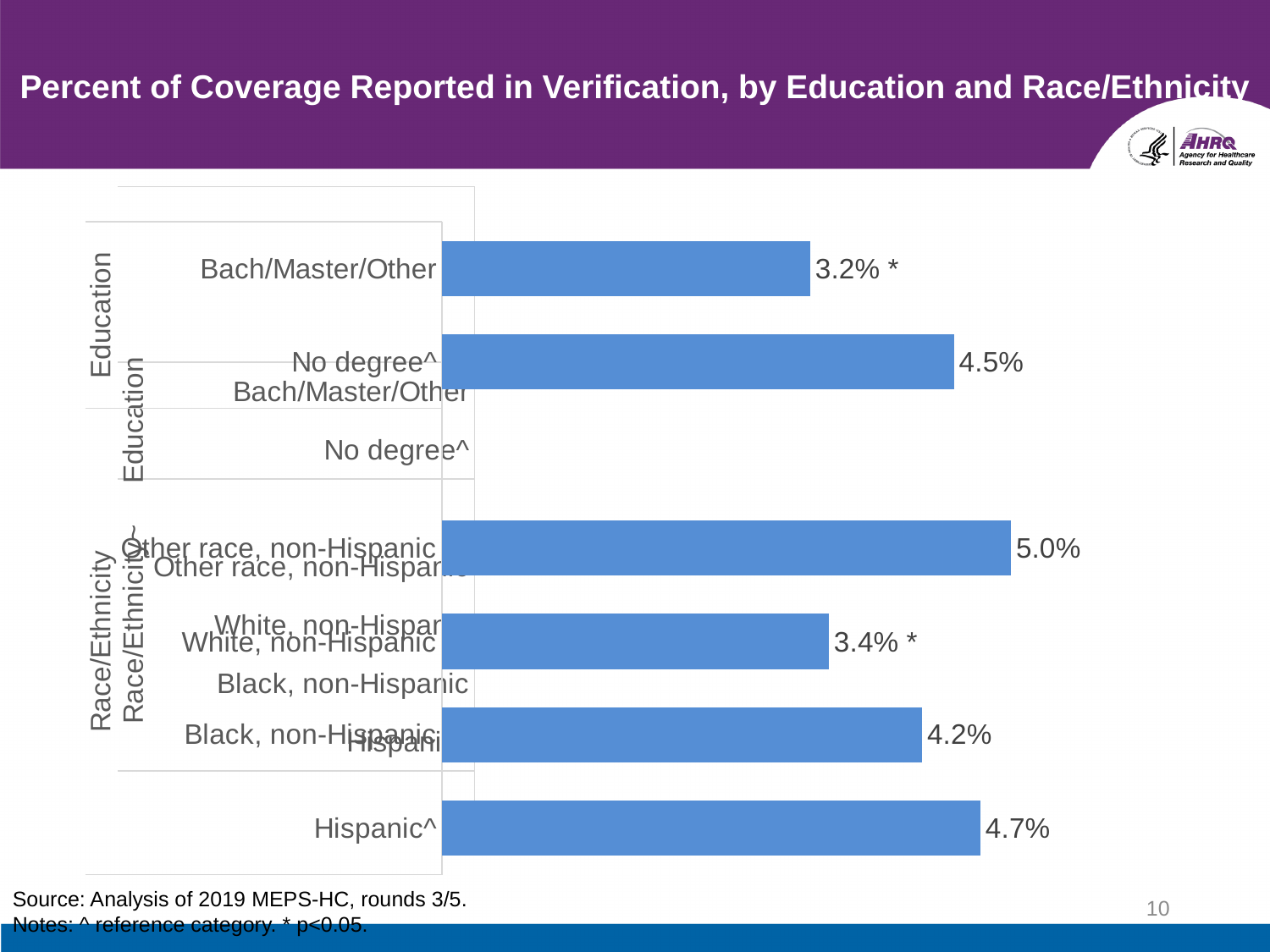
What is the value for No degree^? 4.5% What is the value for Other race, non-Hispanic? 5.0% What kind of chart is shown on the slide? Bar chart What is the value for Bach/Master/Other? 3.2% What is the difference between the values for No degree^ and Bach/Master/Other? 1.3% What is the value for White, non-Hispanic? 3.4% How many bars are plotted in the chart? 6 Which category has the highest value? Other race, non-Hispanic What is the title of the chart? Percent of Coverage Reported in Verification, by Education and Race/Ethnicity Which is larger, the value for Hispanic^ or the value for Black, non-Hispanic? Hispanic^ Which category has the lowest value? Bach/Master/Other What is the value for Hispanic^? 4.7%